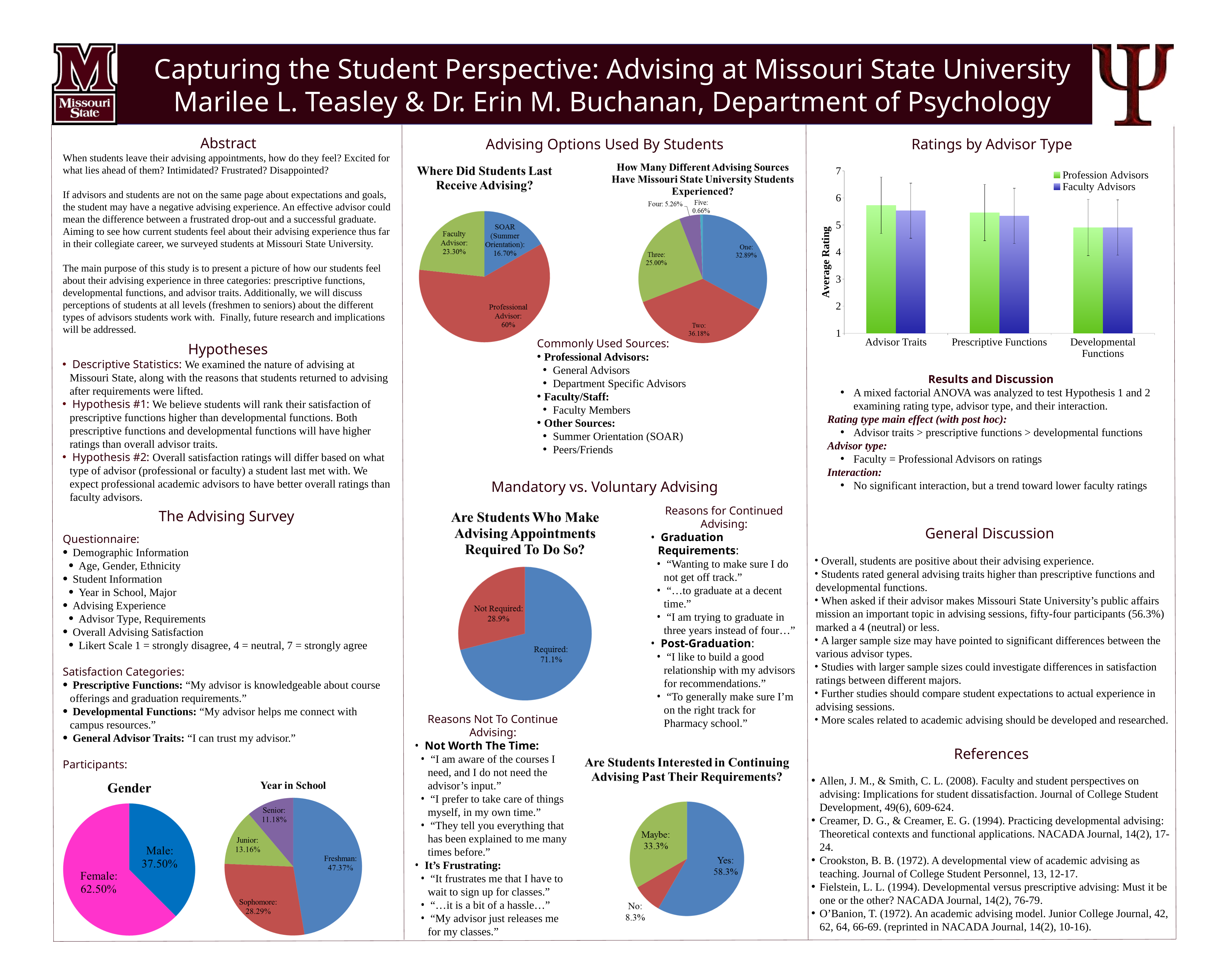
In the "Where Did Students Last Receive Advising?" pie chart, what percentage last received advising from a Faculty Advisor? 23.30% In the "Where Did Students Last Receive Advising?" pie chart, how many categories are shown? 3 In the "How Many Different Advising Sources Have Missouri State University Students Experienced?" pie chart, what is the difference between the One and Three percentages? 7.89% In the "Year in School" pie chart, which year has the smallest share? Senior In the "Year in School" pie chart, which year has the largest share? Freshman In the "Gender" pie chart, what percentage of participants are female? 62.50% In the "How Many Different Advising Sources Have Missouri State University Students Experienced?" pie chart, what is the percentage for Two? 36.18% In the "Year in School" pie chart, what is the percentage for Sophomore? 28.29% In the "Are Students Interested in Continuing Advising Past Their Requirements?" pie chart, which response has the smallest share? No In the "Ratings by Advisor Type" bar chart, is the Profession Advisors value for Advisor Traits greater or less than 5? greater In the "Are Students Who Make Advising Appointments Required To Do So?" pie chart, what percentage are Required? 71.1% In the "Ratings by Advisor Type" bar chart, how many series does the legend list? 2